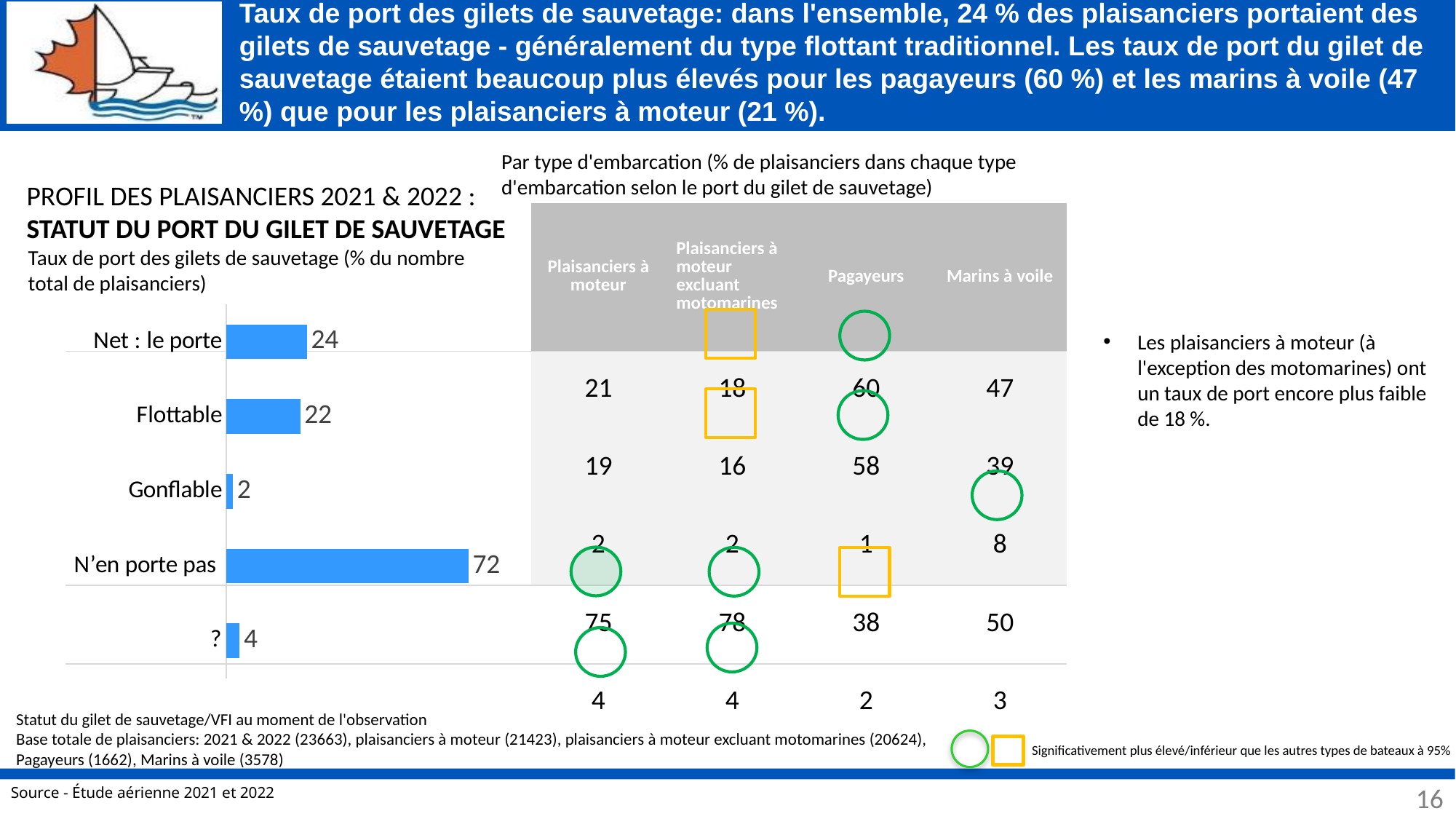
What is the value for "Flottable" in the bar chart? 22 Which category has the lowest value in the bar chart? Gonflable Which category has the highest value in the bar chart? N'en porte pas What is the difference between the values for "N'en porte pas" and "Net : le porte" in the bar chart? 48 What is the value for "Gonflable" in the bar chart? 2 What kind of chart is shown on the left of the slide? Bar chart What is the difference between the values for "Net : le porte" and "Flottable" in the bar chart? 2 What is the value for "Net : le porte" in the bar chart? 24 How many categories are shown in the bar chart? 5 What is the value for "N'en porte pas" in the bar chart? 72 What is the value for the "?" category in the bar chart? 4 Which is larger in the bar chart, the value for "Flottable" or the value for "Gonflable"? Flottable